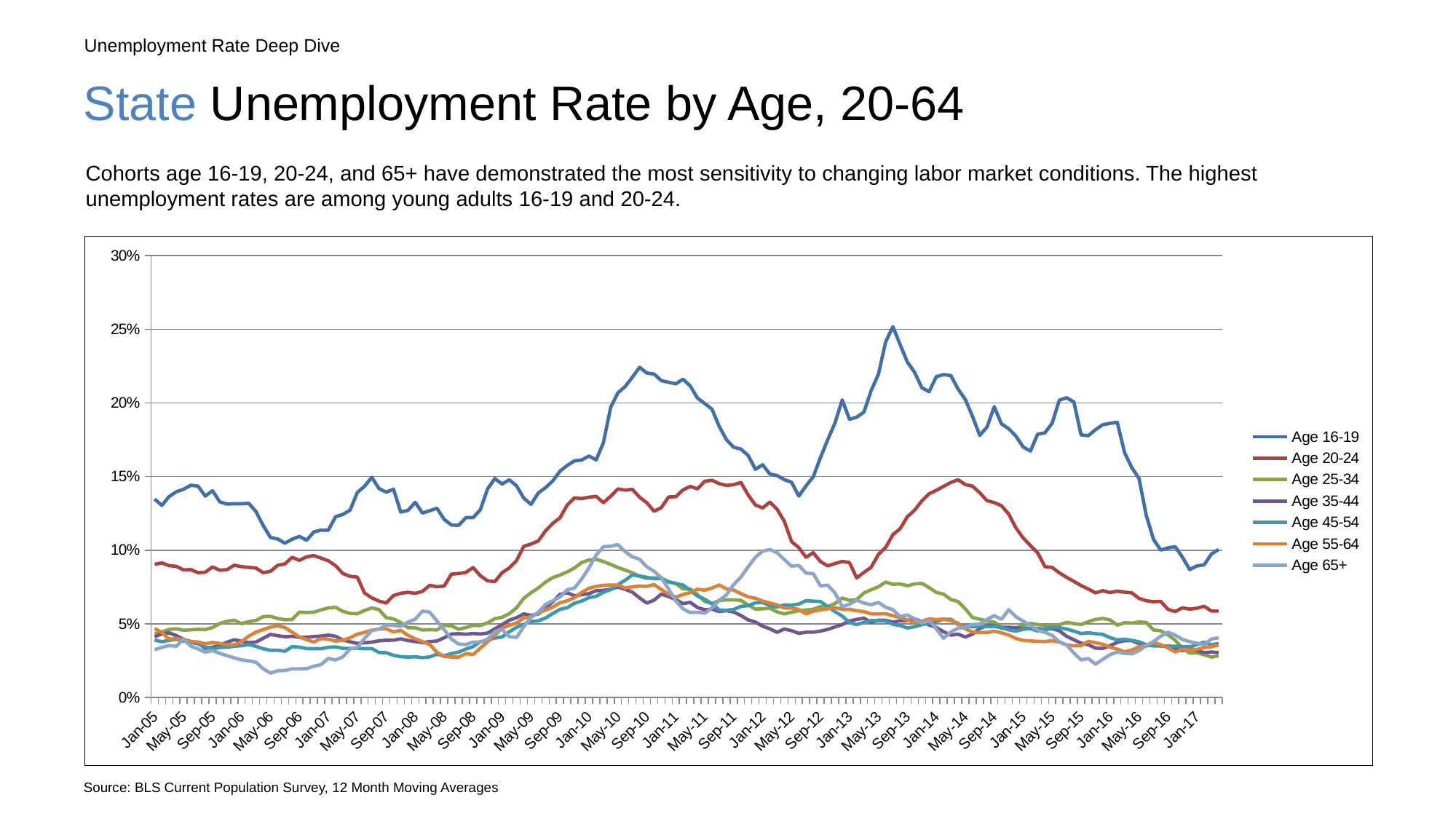
Is the value for Age 20-24 at Jan-05 greater or less than 10%? less Which age group reaches the highest unemployment rate at any point in the chart? Age 16-19 What kind of chart is shown on the slide? line chart How many series does the legend list? 7 Is the value for Age 65+ at May-06 greater or less than 5%? less At Jan-13, which is larger: the value for Age 16-19 or the value for Age 20-24? Age 16-19 Does the Age 16-19 line rise or fall between Jan-16 and Jan-17? fall Is the value for Age 16-19 at Sep-13 greater or less than 20%? greater What is the highest value shown on the vertical axis? 30% Which age group has the lowest unemployment rate at May-06? Age 65+